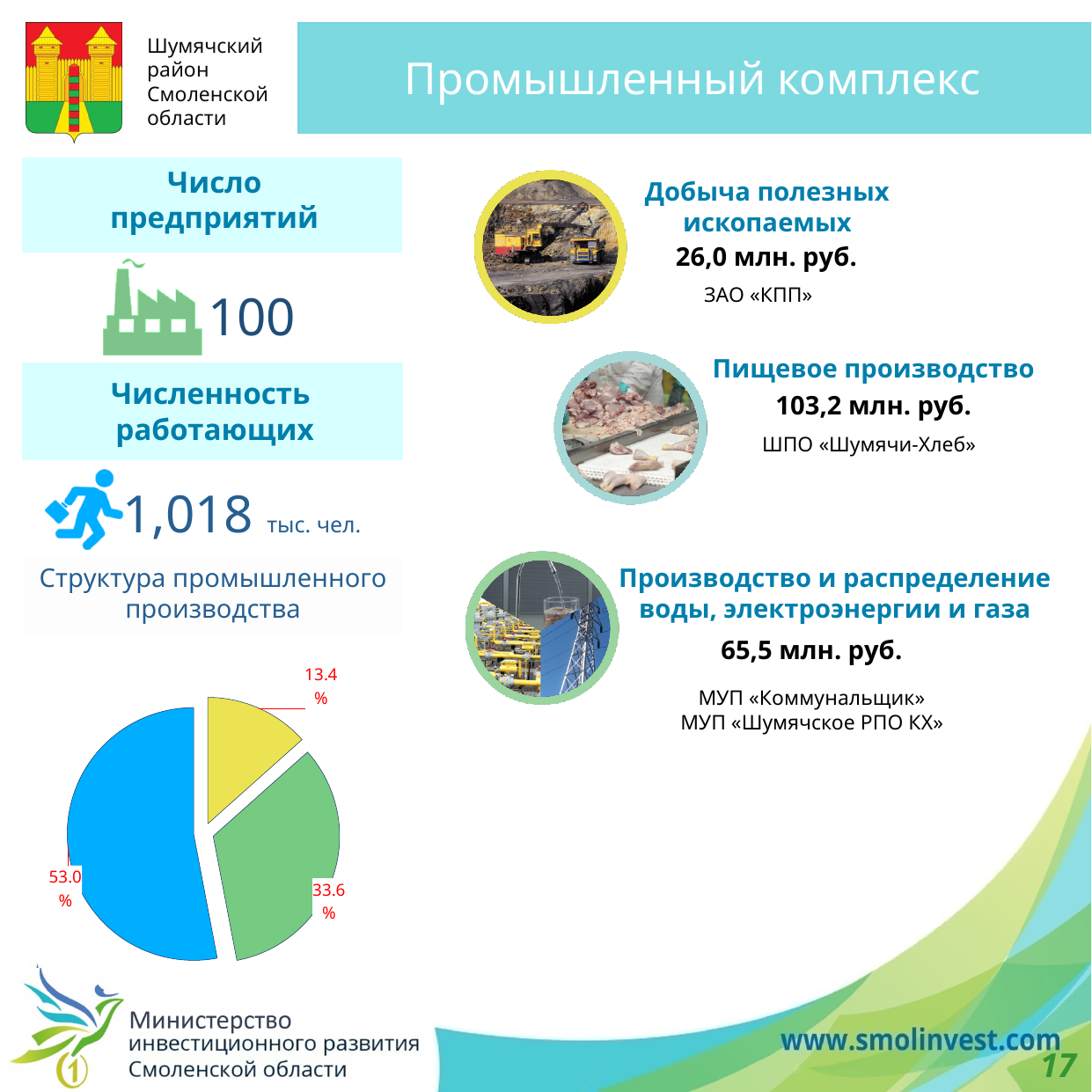
Is the blue slice of the pie chart greater or less than 50%? greater What is the difference in percentage points between the green slice and the yellow slice of the pie chart? 20.2 How many slices does the pie chart have? 3 What percentage is shown for the green slice of the pie chart? 33.6% What share of the pie does the blue slice represent? 53.0% What kind of chart is shown under the heading "Структура промышленного производства"? pie chart Which colour slice of the pie chart is the smallest? yellow What is the title shown above the pie chart? Структура промышленного производства What percentage is shown for the yellow slice of the pie chart? 13.4% What is the difference in percentage points between the blue slice and the green slice of the pie chart? 19.4 Which colour slice of the pie chart is the largest? blue Which is larger in the pie chart, the green slice or the yellow slice? green slice